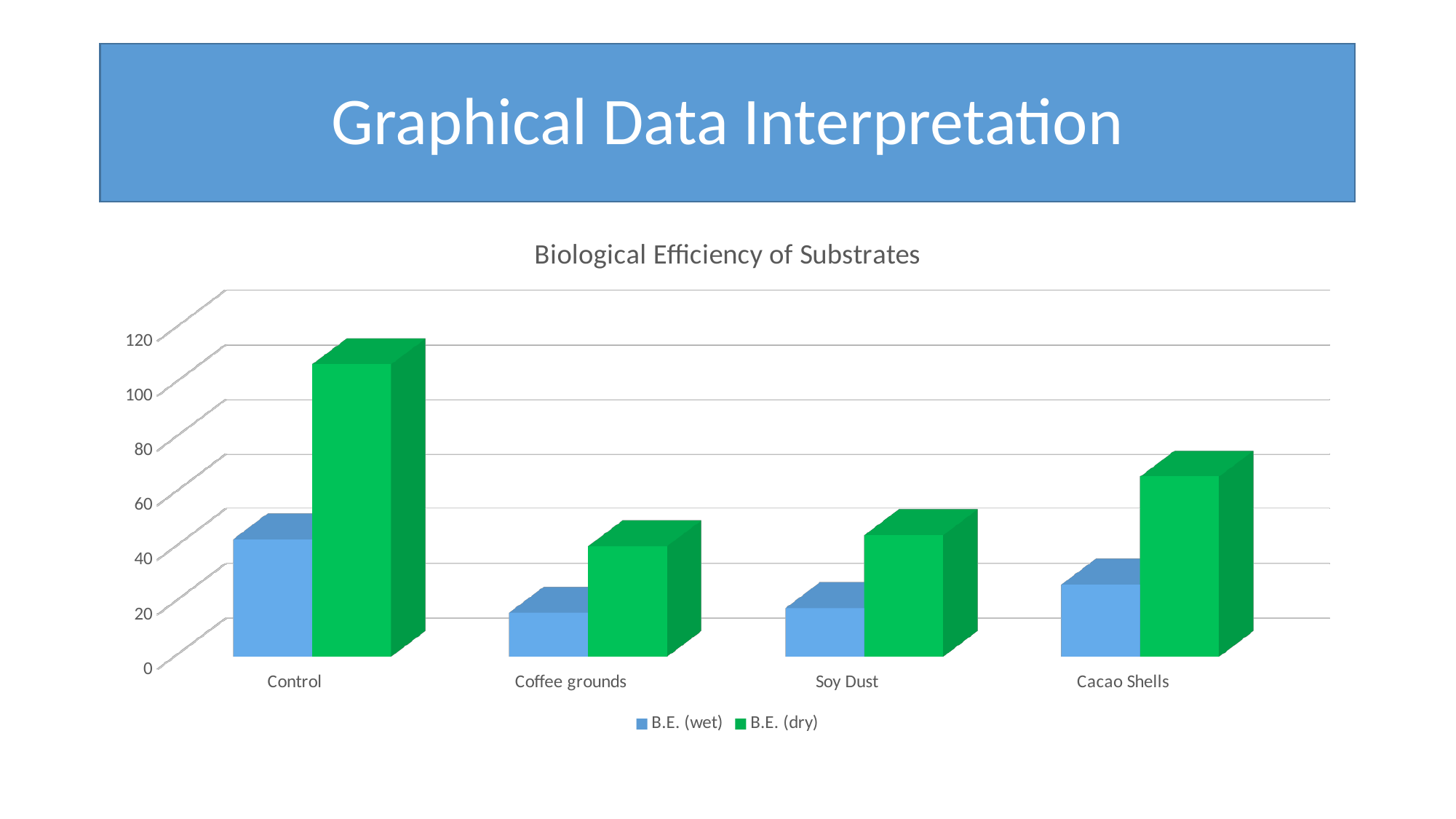
Which category has the highest B.E. (dry) value? Control Is the B.E. (dry) value for Control greater or less than 100? greater What colour represents the B.E. (dry) series? green Which category has the highest B.E. (wet) value? Control How many substrate categories are shown on the x axis? 4 Which is larger, the B.E. (dry) value for Control or for Cacao Shells? Control How many series does the legend list? 2 What kind of chart is shown on the slide? bar chart What is the title of the chart? Biological Efficiency of Substrates Is the B.E. (wet) value for Coffee grounds greater or less than 40? less Which is larger, the B.E. (wet) value for Cacao Shells or for Coffee grounds? Cacao Shells Is the B.E. (dry) value for Cacao Shells greater or less than 60? greater